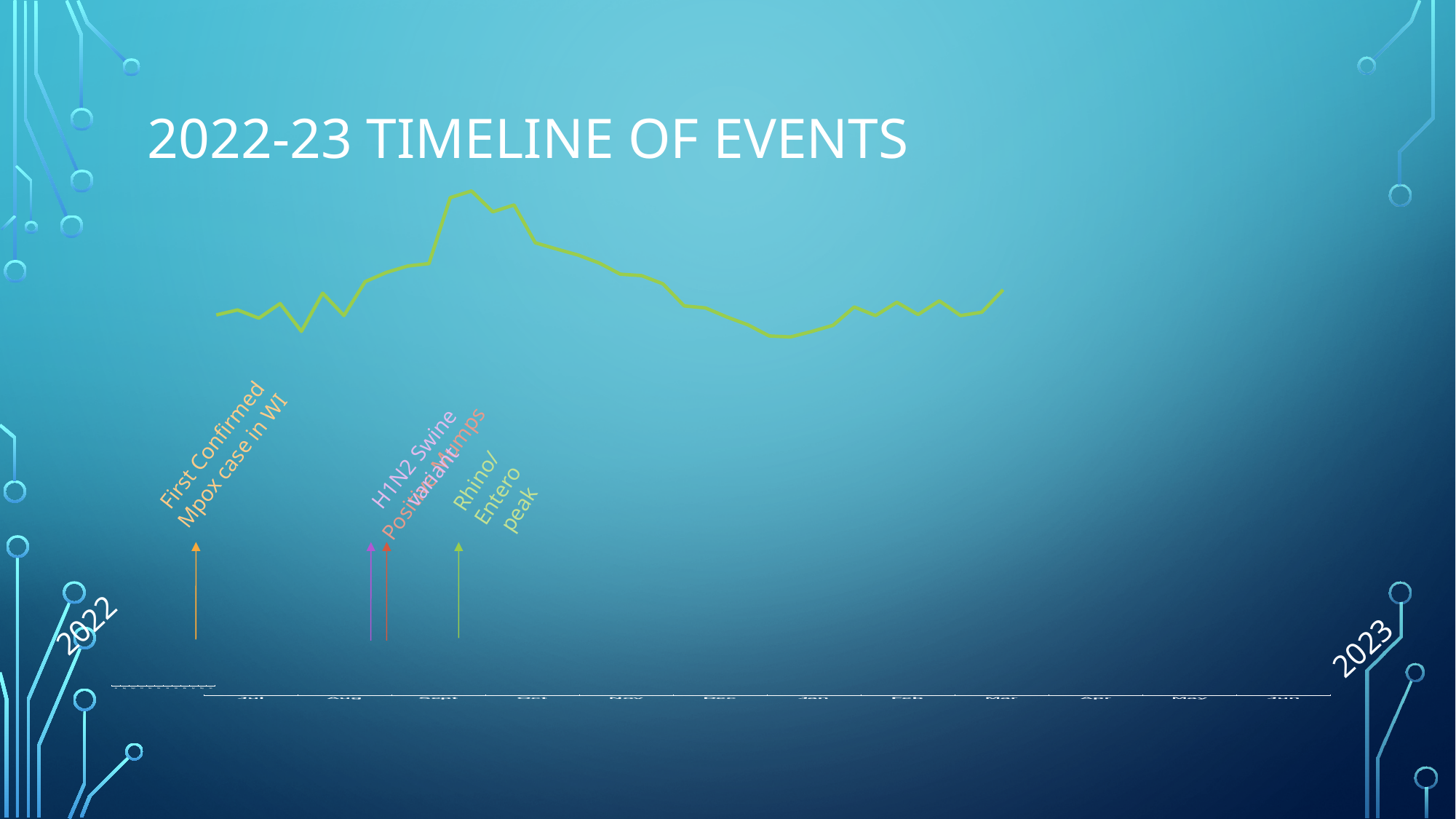
Is the value of the line higher near Jul or near Jan? Jul Around which month does the line reach its highest point? Sept What kind of chart is shown on the slide? line chart Around which month does the line reach its lowest point? Jan Does the line rise or fall between Jul and its peak near Sept? rise How many month labels are shown along the x axis of the chart? 12 What is the title of the slide containing the chart? 2022-23 Timeline of Events Does the line rise or fall between its peak near Sept and Jan? fall How many lines are plotted on the chart? 1 Which month label is first on the x axis of the chart? Jul Is the value of the line higher near Sept or near Dec? Sept